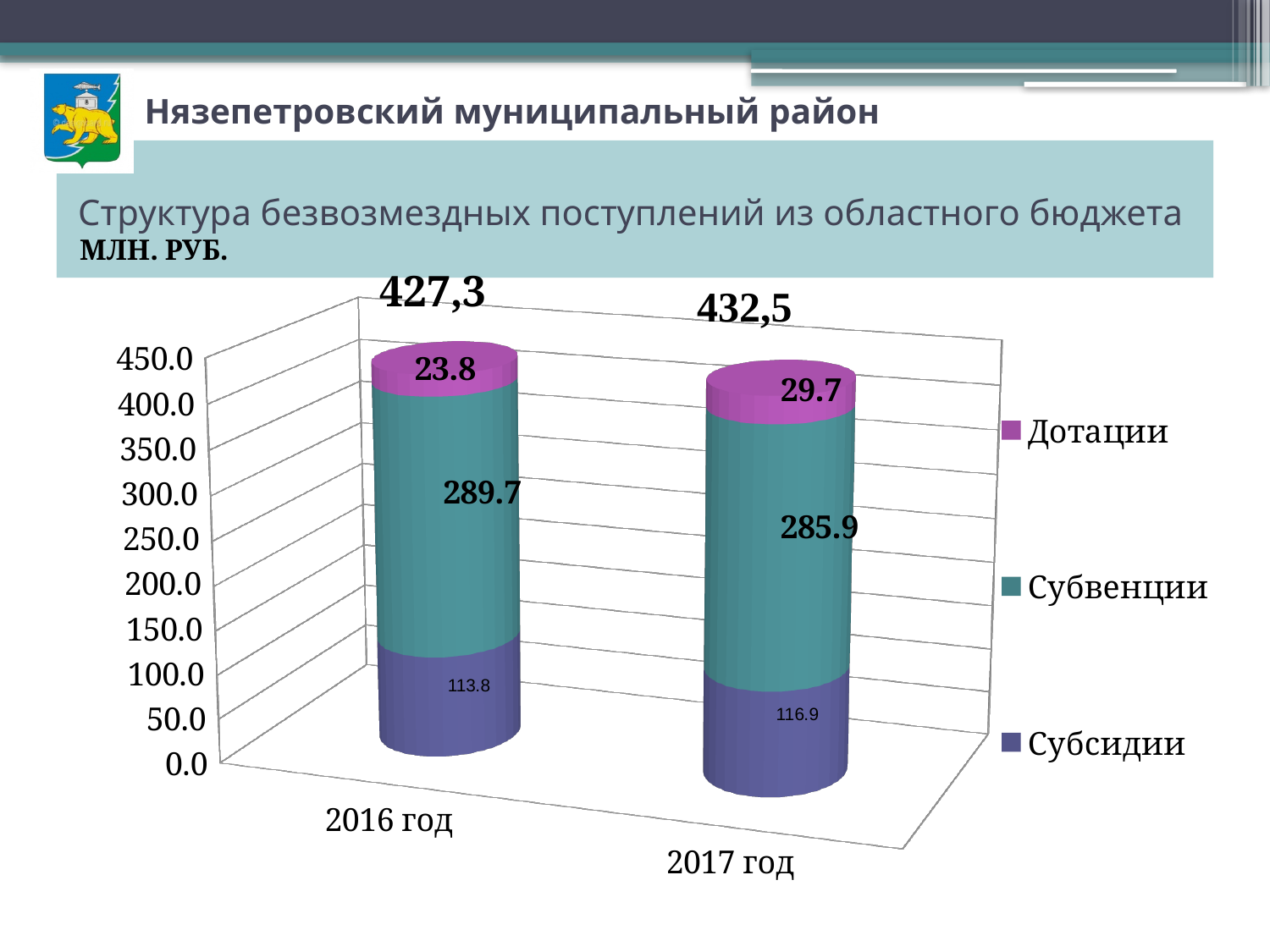
What is the total shown above the stacked bar for 2017 год? 432,5 What is the value of Субсидии for 2016 год? 113.8 Which is larger: Субвенции in 2016 год or Субвенции in 2017 год? Субвенции in 2016 год Which series has the smallest value in 2016 год? Дотации What is the value of Субсидии for 2017 год? 116.9 What is the value of Дотации for 2017 год? 29.7 What is the total shown above the stacked bar for 2016 год? 427,3 What is the value of Субвенции for 2016 год? 289.7 What is the difference between the Дотации values for 2017 год and 2016 год? 5.9 How many series does the legend list? 3 What kind of chart is shown on the slide? Stacked bar chart Which series has the largest value in 2017 год? Субвенции